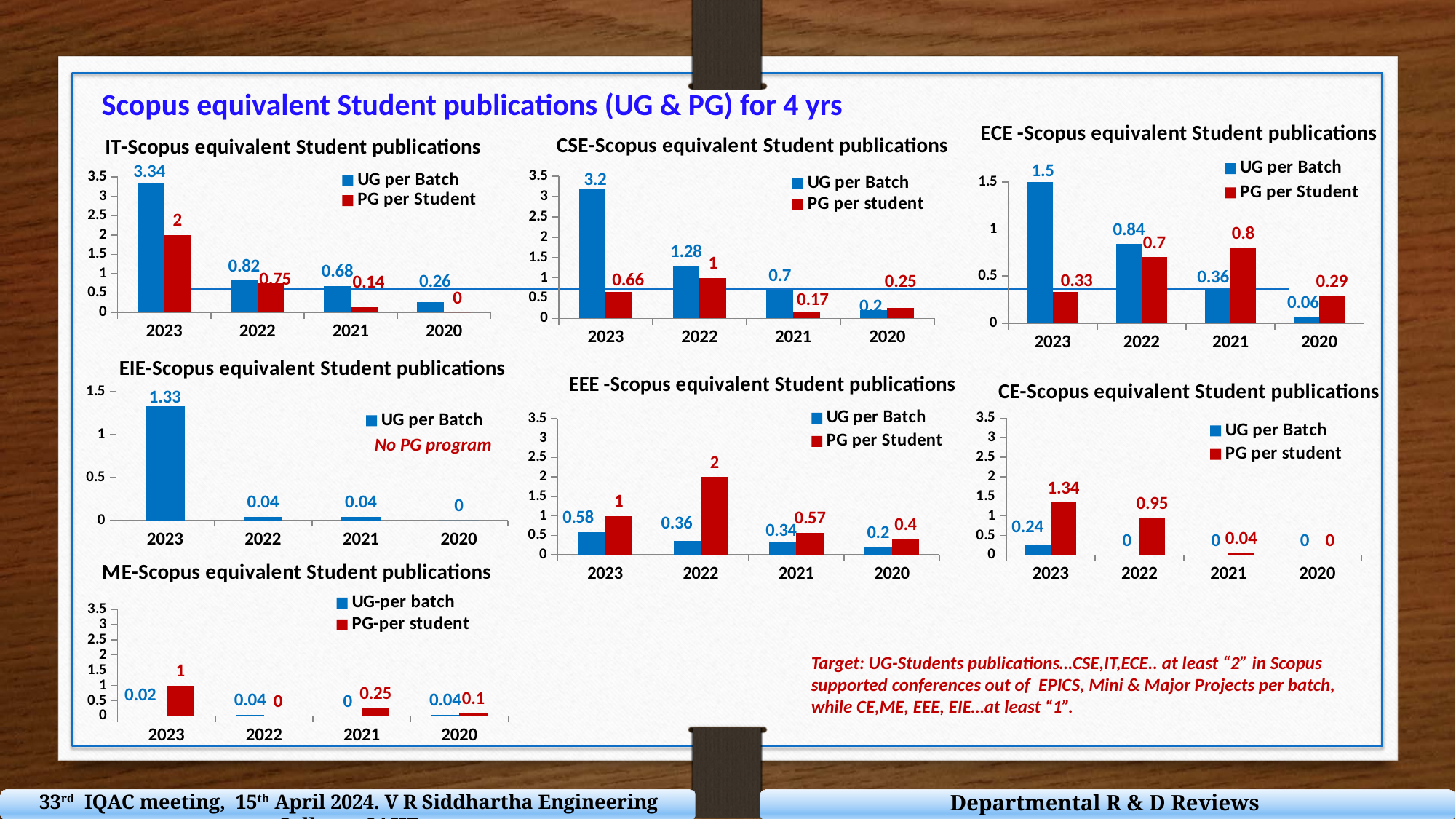
In the IT-Scopus equivalent Student publications chart, what is the difference between the UG per Batch and PG per Student values for 2023? 1.34 In the IT-Scopus equivalent Student publications chart, what is the UG per Batch value for 2023? 3.34 How many series does the legend of the EIE-Scopus equivalent Student publications chart list? 1 In the ECE-Scopus equivalent Student publications chart, which year has the highest PG per Student value? 2021 In the EIE-Scopus equivalent Student publications chart, does the UG per Batch value rise or fall from 2023 to 2020? Fall What note is shown in place of a PG series in the EIE-Scopus equivalent Student publications chart? No PG program In the EEE-Scopus equivalent Student publications chart, which year has the lowest UG per Batch value? 2020 In the CSE-Scopus equivalent Student publications chart, is the UG per Batch value for 2023 greater or less than 3? greater What kind of chart is the ECE-Scopus equivalent Student publications chart? Bar chart In the CE-Scopus equivalent Student publications chart, which is larger for 2023: UG per Batch or PG per student? PG per student How many years are shown on the x axis of the ME-Scopus equivalent Student publications chart? 4 In the CSE-Scopus equivalent Student publications chart, what is the PG per student value for 2022? 1